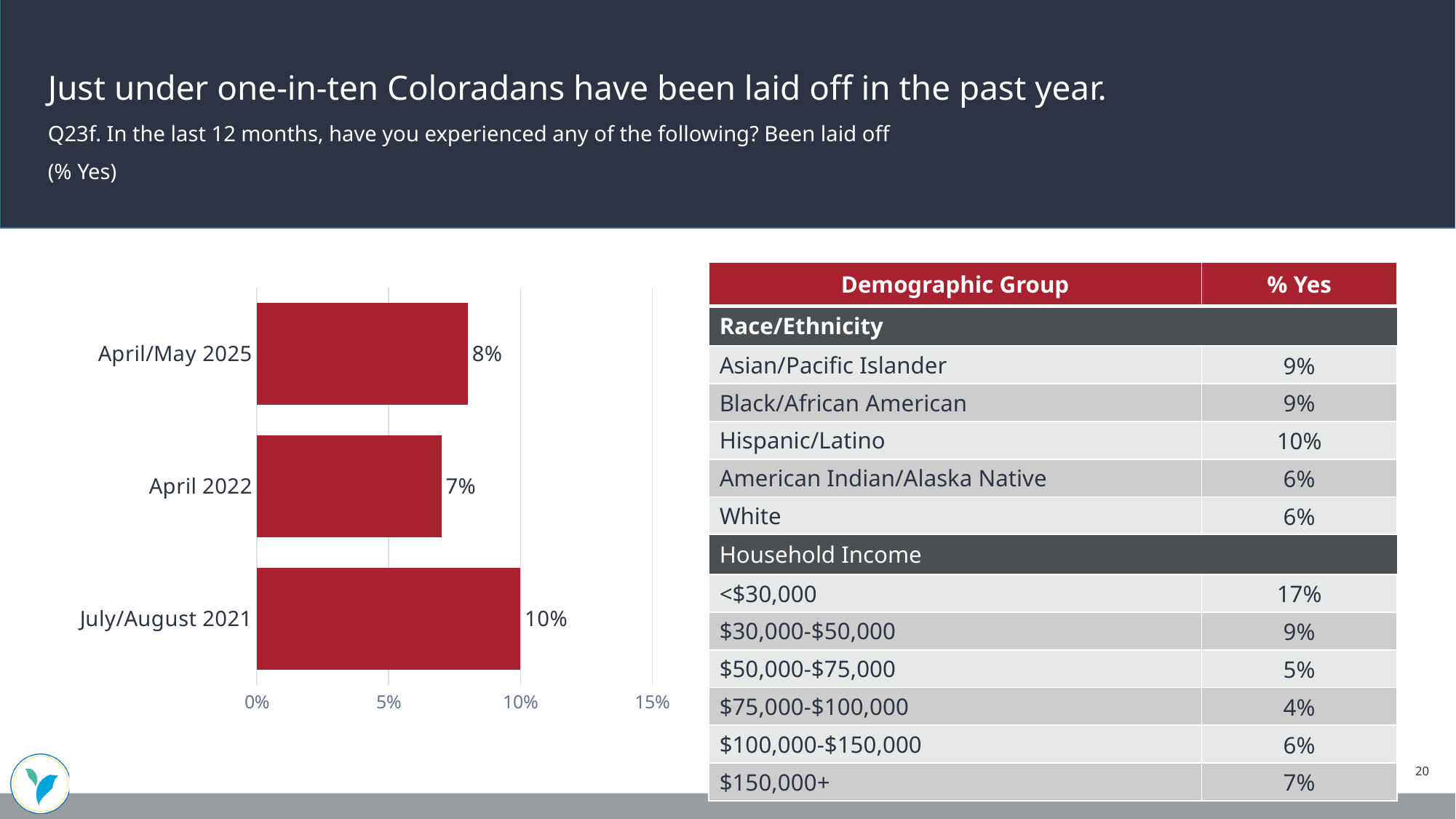
In the bar chart, which is larger: the value for April/May 2025 or the value for July/August 2021? July/August 2021 Is the value for April 2022 in the bar chart greater or less than 10%? less What kind of chart is shown on the left of the slide? bar chart Which survey period has the lowest value in the bar chart? April 2022 Which survey period has the highest value in the bar chart? July/August 2021 What is the value for April 2022 in the bar chart? 7% From July/August 2021 to April 2022, did the value in the bar chart rise or fall? fall What is the value for April/May 2025 in the bar chart? 8% What is the difference between the July/August 2021 value and the April 2022 value in the bar chart? 3% How many survey periods are shown in the bar chart? 3 What is the difference between the April/May 2025 value and the April 2022 value in the bar chart? 1% What is the value for July/August 2021 in the bar chart? 10%